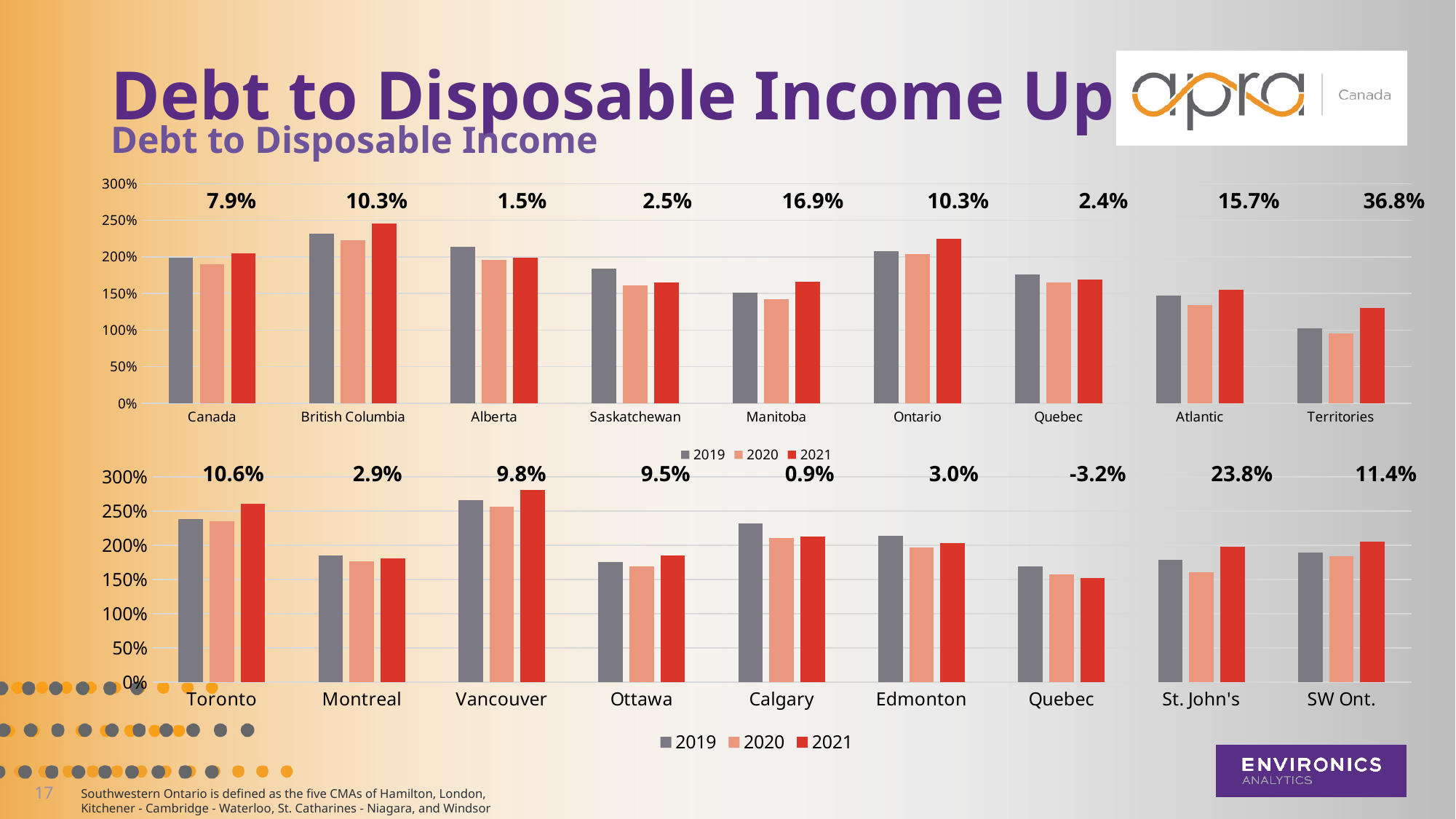
How many categories are shown on the x axis of the top chart? 9 How many series does the legend of the bottom chart list? 3 In the top chart, which category has the highest 2021 bar? British Columbia What kind of chart is the top chart on the slide? bar chart In the top chart, is the 2021 value for British Columbia greater or less than 200%? greater In the bottom chart, which is larger for Quebec: the 2019 bar or the 2021 bar? 2019 In the top chart, what percentage label is printed above the Territories group? 36.8% In the top chart, which category has the lowest 2021 bar? Territories In the bottom chart, what percentage label is printed above the St. John's group? 23.8% In the bottom chart, is the 2021 value for Vancouver greater or less than 250%? greater In the bottom chart, what percentage label is printed above the Quebec group? -3.2% In the bottom chart, which category has the highest 2021 bar? Vancouver